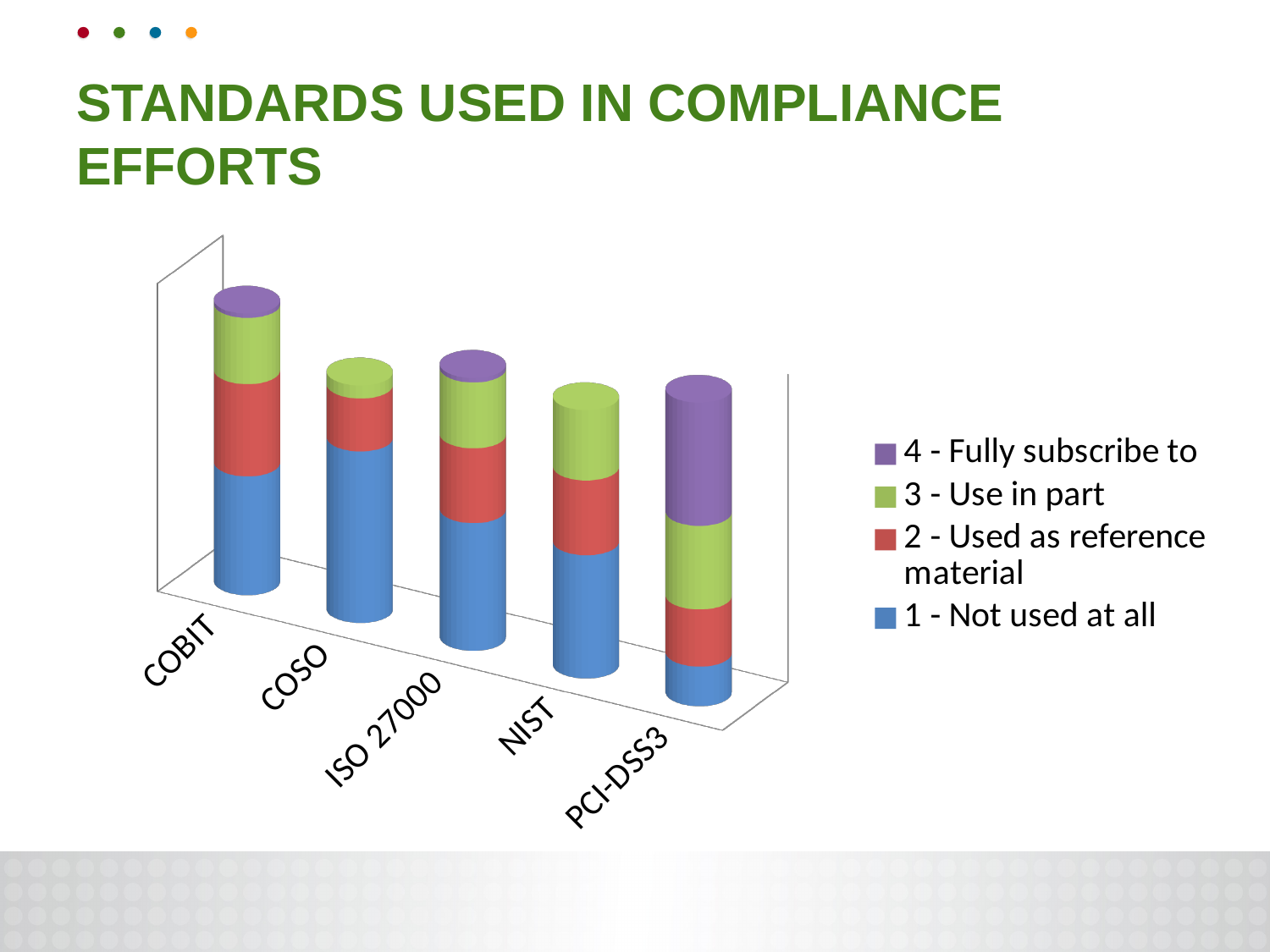
Which has the larger '1 - Not used at all' segment, NIST or PCI-DSS3? NIST Which has the larger '3 - Use in part' segment, COBIT or COSO? COBIT How many standards (categories) are shown on the x axis of the chart? 5 Which standard has the smallest '1 - Not used at all' segment? PCI-DSS3 Which has the larger '4 - Fully subscribe to' segment, COBIT or PCI-DSS3? PCI-DSS3 Which legend entry is shown in purple? 4 - Fully subscribe to How many series does the chart's legend list? 4 Which standard has the largest '4 - Fully subscribe to' segment? PCI-DSS3 What kind of chart is shown on the slide? Stacked bar chart What colour represents '1 - Not used at all' in the chart? Blue